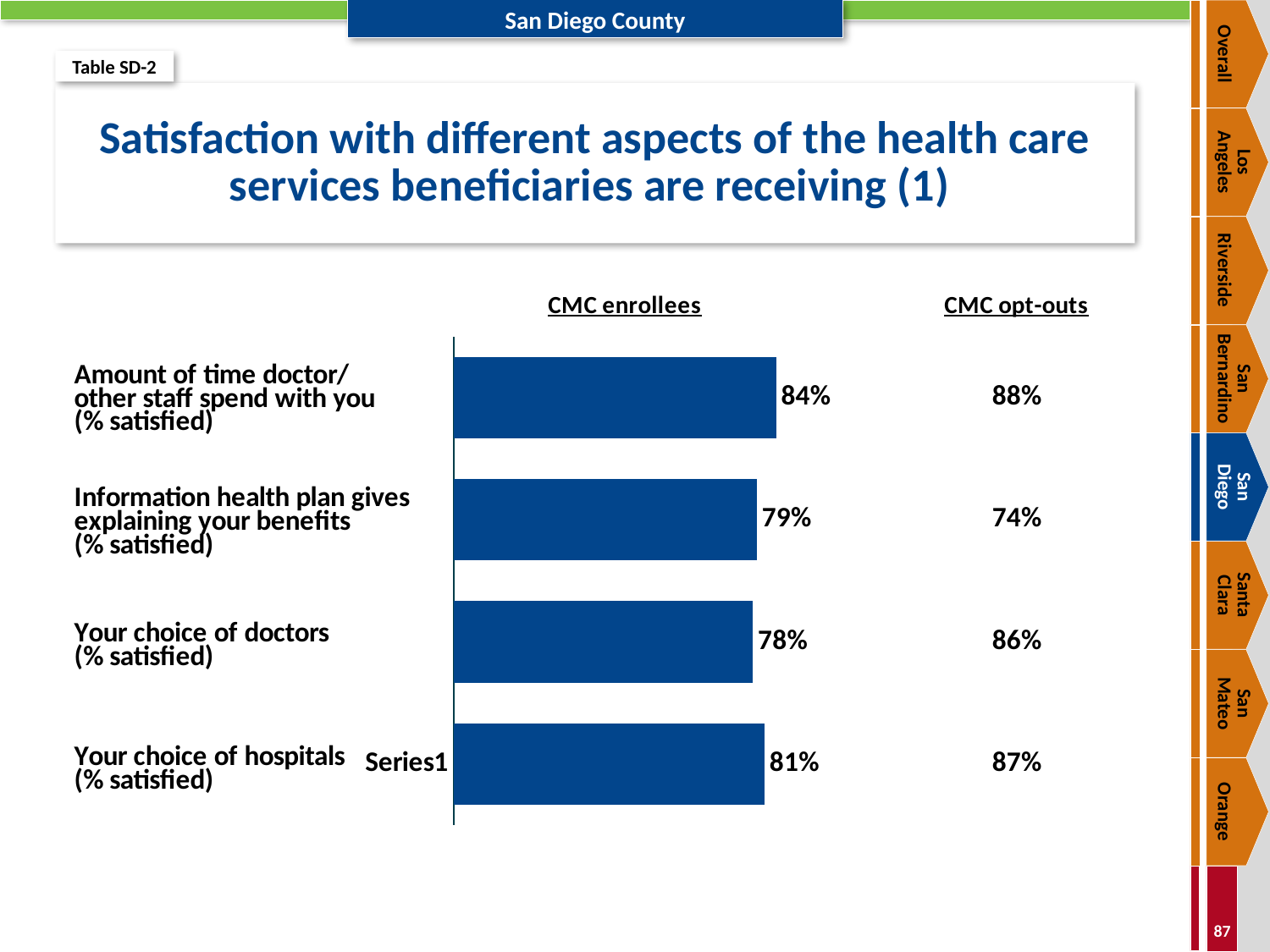
Which category has the highest CMC enrollees satisfaction? Amount of time doctor/other staff spend with you (% satisfied) What is the difference between the CMC enrollees values for 'Amount of time doctor/other staff spend with you' and 'Your choice of doctors'? 6% What is the CMC enrollees value for 'Your choice of hospitals (% satisfied)'? 81% For 'Your choice of hospitals (% satisfied)', which is larger: the CMC enrollees value or the CMC opt-outs value? CMC opt-outs Which category has the lowest CMC enrollees satisfaction? Your choice of doctors (% satisfied) What is the CMC enrollees value for 'Amount of time doctor/other staff spend with you (% satisfied)'? 84% How many categories are plotted in the bar chart? 4 For 'Information health plan gives explaining your benefits (% satisfied)', which is larger: the CMC enrollees value or the CMC opt-outs value? CMC enrollees What type of chart is shown on the slide? Bar chart What is the CMC enrollees value for 'Your choice of doctors (% satisfied)'? 78% What is the CMC opt-outs value for 'Information health plan gives explaining your benefits (% satisfied)'? 74% What is the title of the chart on the slide? Satisfaction with different aspects of the health care services beneficiaries are receiving (1)